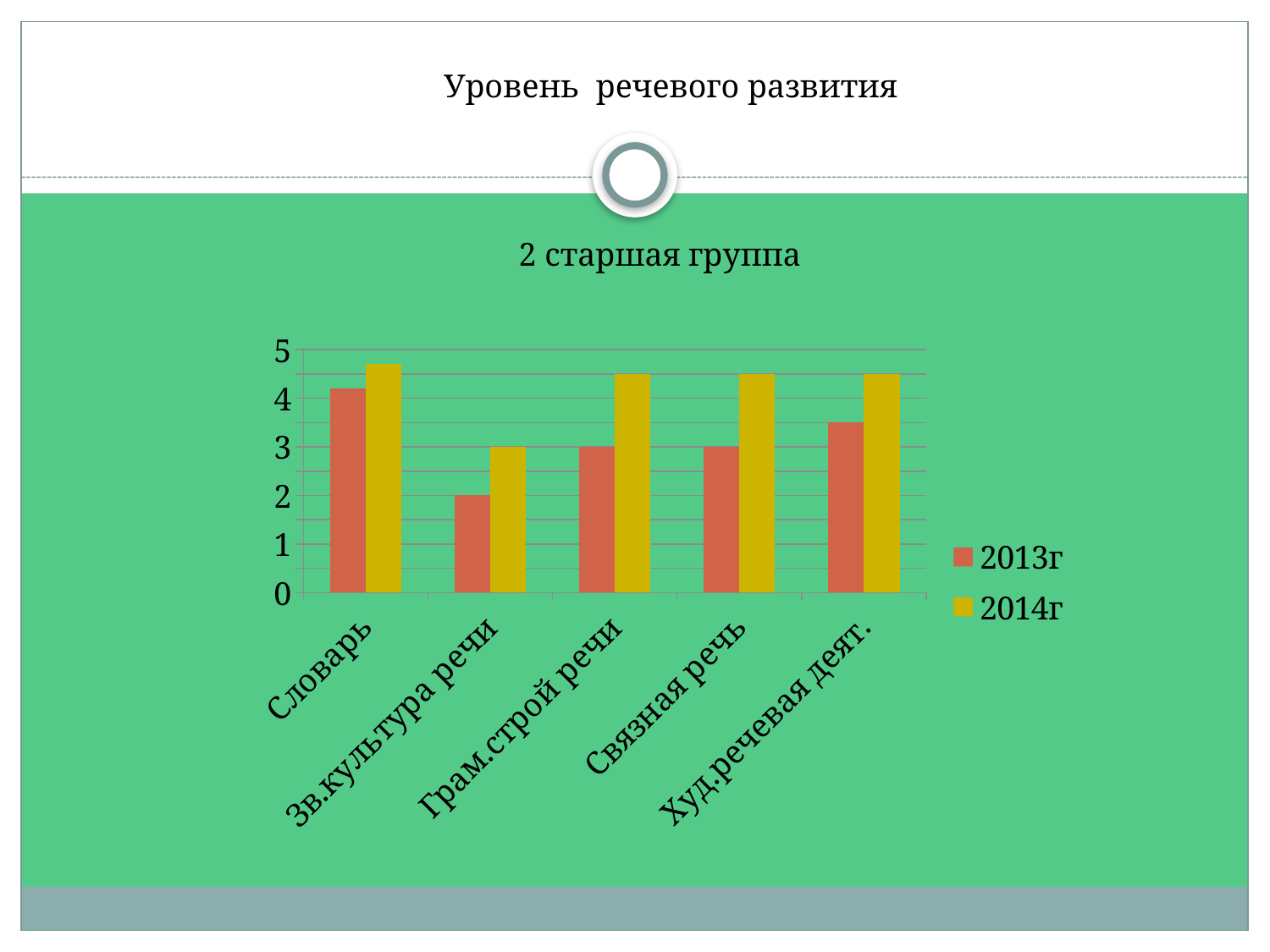
Which category has the highest value in the 2013г series? Словарь What is the value for Зв.культура речи in the 2014г series? 3 What is the title of the chart? 2 старшая группа What is the value for Зв.культура речи in the 2013г series? 2 In the 2013г series, which is larger: Словарь or Худ.речевая деят.? Словарь What is the value for Грам.строй речи in the 2013г series? 3 How many categories are shown on the x axis of the chart? 5 Is the value for Словарь in the 2013г series greater or less than 4? greater What kind of chart is shown on the slide? bar chart What is the difference between the 2014г and 2013г values for Зв.культура речи? 1 Which category has the lowest value in the 2014г series? Зв.культура речи How many series does the chart legend list? 2